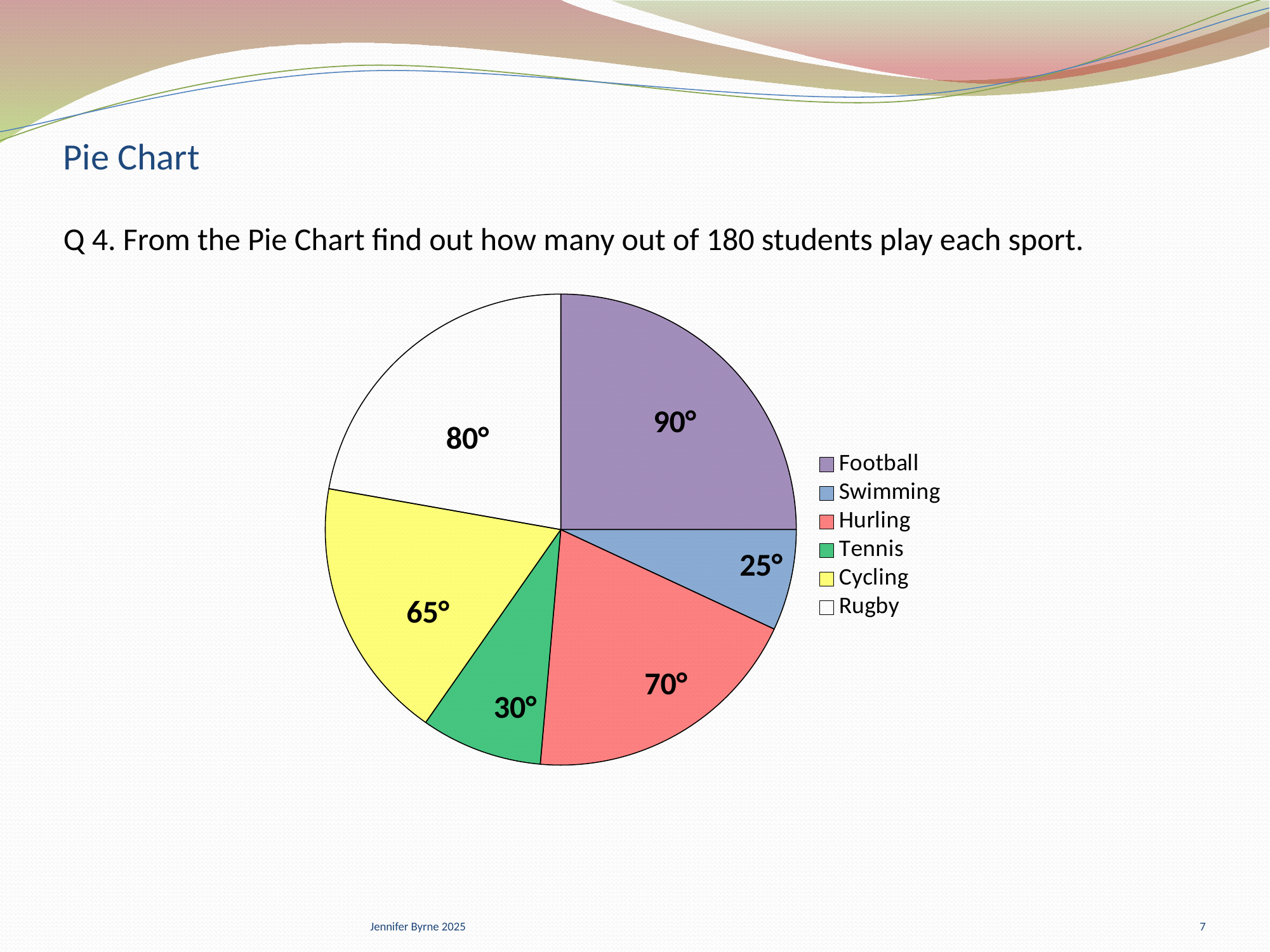
What angle is shown for the Hurling slice of the pie chart? 70° What angle is shown for the Football slice of the pie chart? 90° What colour is the Tennis slice in the pie chart? Green What type of chart is shown on the slide? Pie chart How many sports are shown in the pie chart? 6 What angle is shown for the Cycling slice of the pie chart? 65° Which sport has the largest slice of the pie chart? Football Which sport has the smallest slice of the pie chart? Swimming What is the difference in degrees between the Rugby slice and the Tennis slice? 50° What angle is shown for the Swimming slice of the pie chart? 25° What share of the pie does the Football slice represent? 25% Which slice is larger, Hurling or Cycling? Hurling